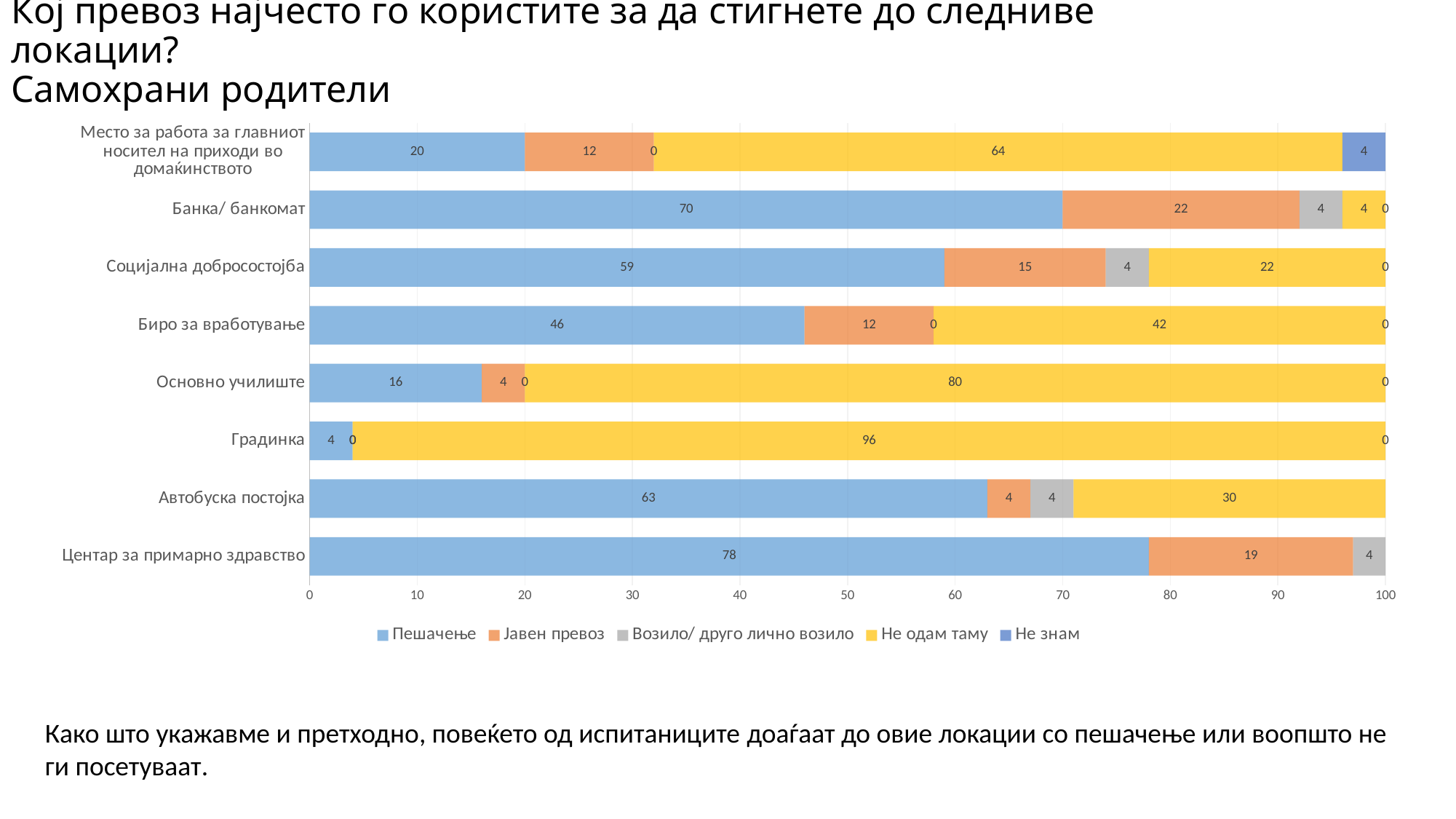
What is the value of Не знам for Место за работа за главниот носител на приходи во домаќинството? 4 What is the value of Пешачење for Банка/ банкомат? 70 What colour represents the Не одам таму series in the chart? Yellow What kind of chart is shown on the slide? Bar chart What is the value of Јавен превоз for Центар за примарно здравство? 19 What is the value of Не одам таму for Градинка? 96 Which has a larger Јавен превоз value, Банка/ банкомат or Социјална добросостојба? Банка/ банкомат How many location categories are plotted on the chart? 8 How many series does the legend list? 5 What is the difference between the Не одам таму values for Основно училиште and Биро за вработување? 38 Which location has the lowest value for Пешачење? Градинка Which location has the highest value for Пешачење? Центар за примарно здравство